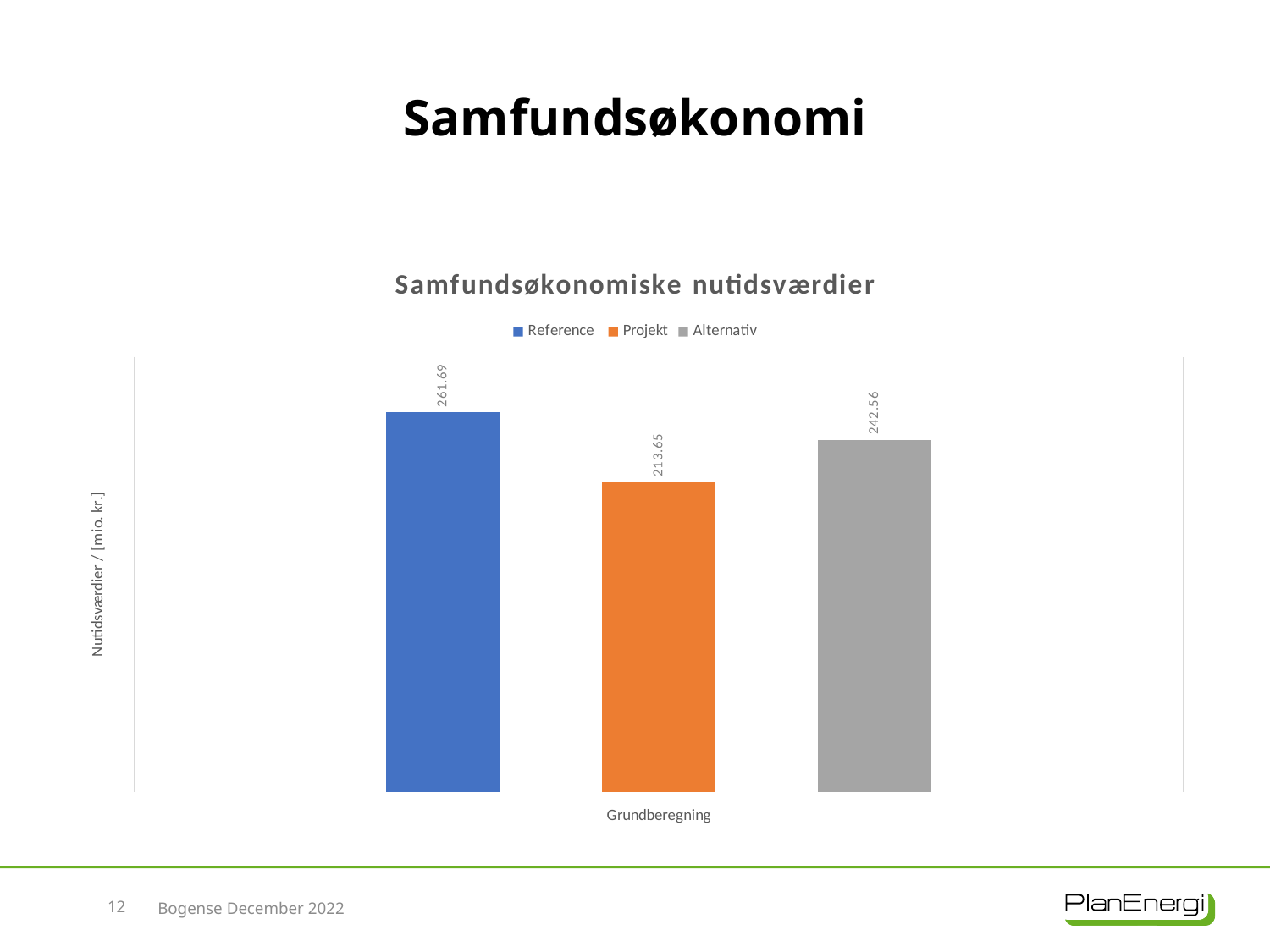
Which is larger in the Samfundsøkonomiske nutidsværdier chart, the Reference value or the Alternativ value? Reference What is the value for the Projekt series in the Samfundsøkonomiske nutidsværdier chart? 213.65 Which series has the lowest value in the Samfundsøkonomiske nutidsværdier chart? Projekt How many series does the legend of the Samfundsøkonomiske nutidsværdier chart list? 3 What is the y-axis label of the Samfundsøkonomiske nutidsværdier chart? Nutidsværdier / [mio. kr.] What is the difference between the Reference and Projekt values in the Samfundsøkonomiske nutidsværdier chart? 48.04 What is the value for the Alternativ series in the Samfundsøkonomiske nutidsværdier chart? 242.56 What is the value for the Reference series in the Samfundsøkonomiske nutidsværdier chart? 261.69 Which series has the highest value in the Samfundsøkonomiske nutidsværdier chart? Reference How many categories are shown on the x axis of the Samfundsøkonomiske nutidsværdier chart? 1 What kind of chart is shown on the slide? Bar chart What is the difference between the Alternativ and Projekt values in the Samfundsøkonomiske nutidsværdier chart? 28.91